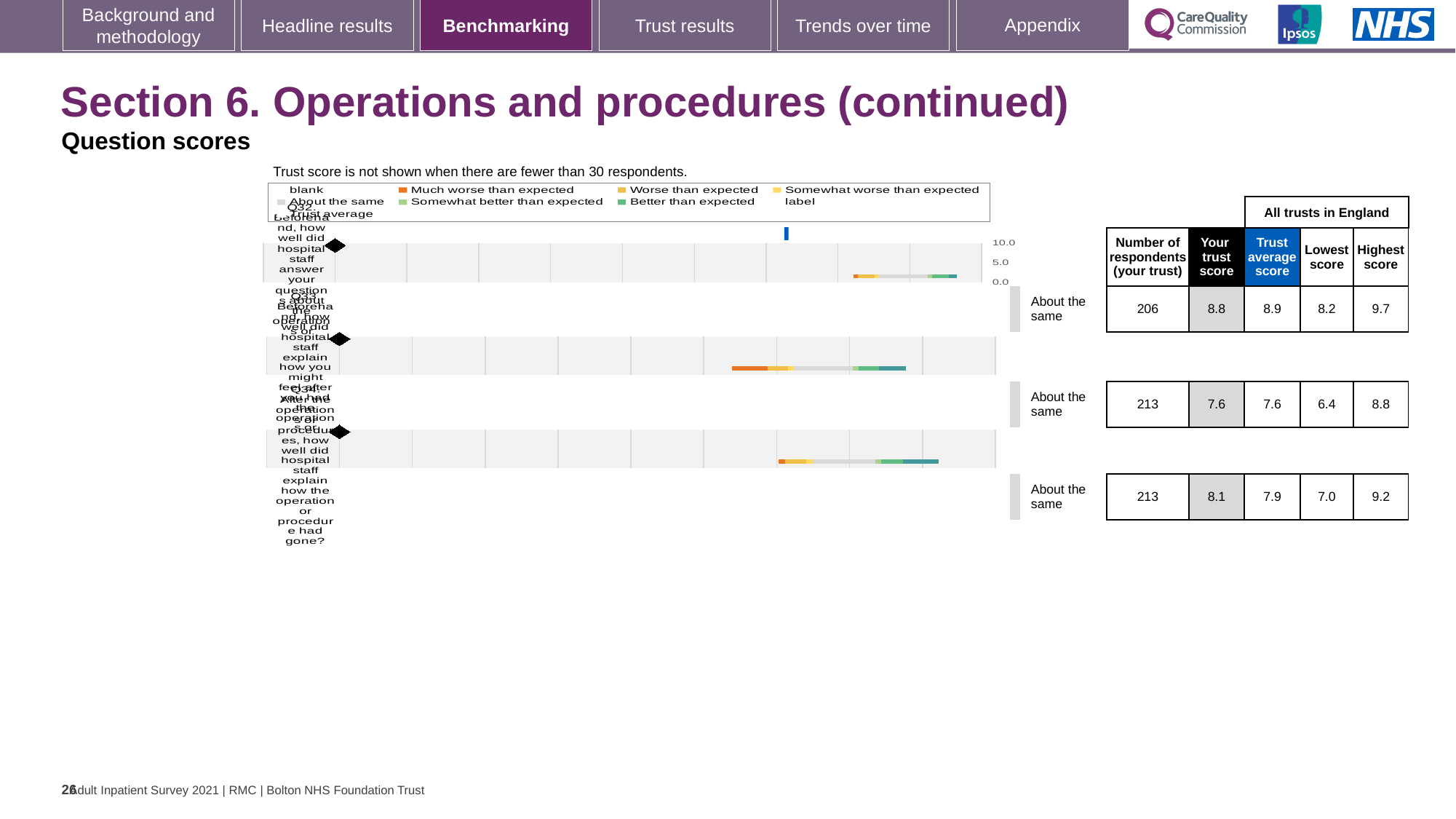
According to the table, what is the trust average score for Q34 (how well staff explained how the operation or procedure had gone)? 7.9 What kind of chart is used for the Q32, Q33 and Q34 benchmarking displays on this slide? bar chart Which of the three questions has the lowest 'Lowest score' in the table? Q33 What is the difference between the highest score and the lowest score for Q33 in the table? 2.4 According to the table, what is your trust score for Q33 (how well staff explained how you might feel after the operation)? 7.6 How many question benchmarking charts are shown on the slide? 3 According to the table, what is the highest score across all trusts in England for Q32? 9.7 According to the table, what is the number of respondents for Q32 (how well staff answered questions about the operation or procedure)? 206 What is the highest tick value shown on the horizontal axis of the Q32 chart? 10.0 Which of the three questions has the highest 'Your trust score' in the table? Q32 For Q34, which is larger in the table: your trust score or the trust average score? Your trust score What benchmark category label is shown next to the Q32 chart? About the same